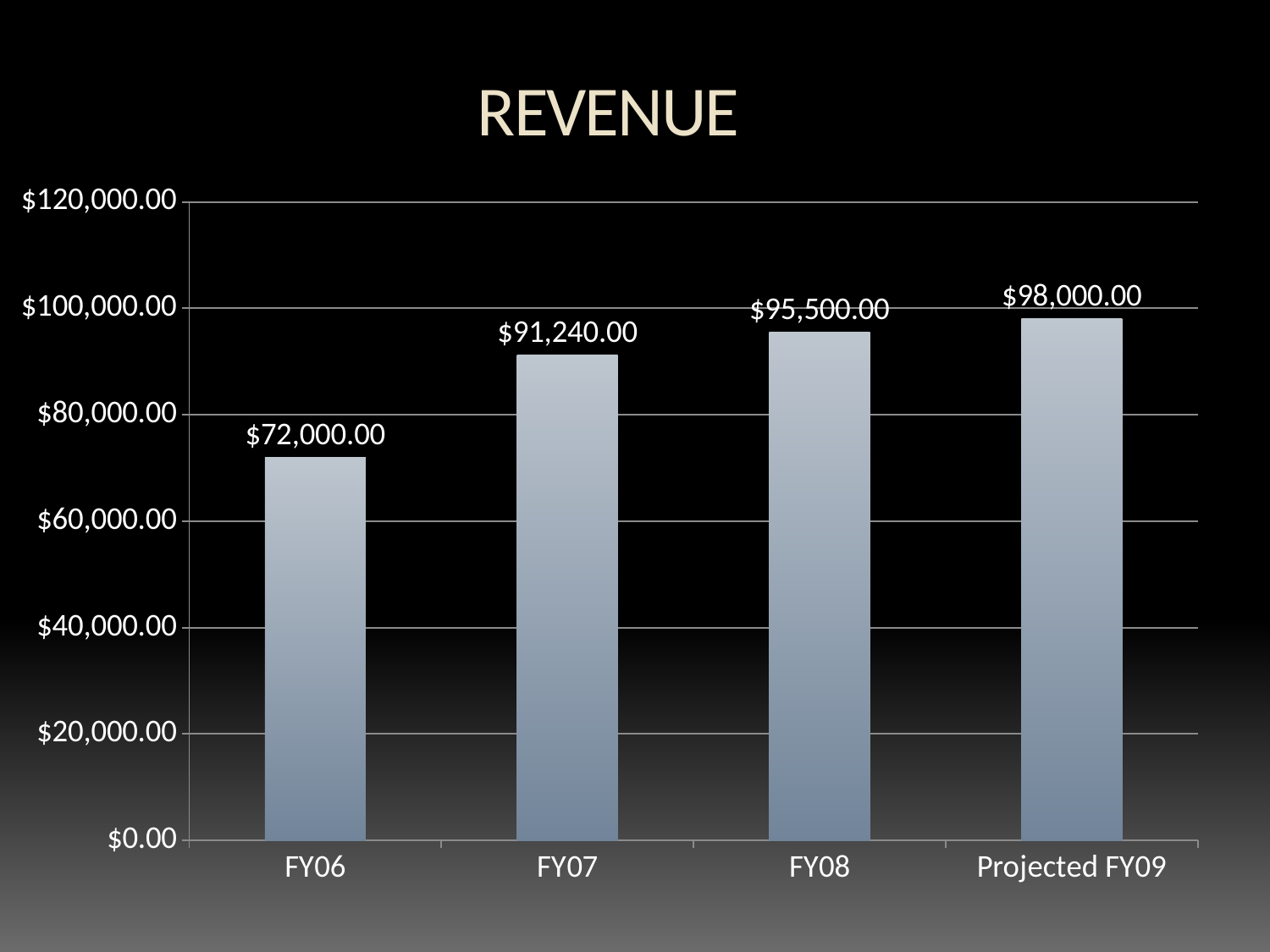
What kind of chart is shown on the slide? bar chart What is the revenue for Projected FY09? $98,000.00 Is the revenue for FY07 greater or less than $100,000.00? less What is the difference in revenue between FY07 and FY06? $19,240.00 What is the revenue for FY07? $91,240.00 Which category has the lowest revenue? FY06 What is the revenue for FY08? $95,500.00 How many categories are shown on the x axis? 4 Which has higher revenue, FY06 or FY08? FY08 What is the revenue for FY06? $72,000.00 What is the difference in revenue between Projected FY09 and FY08? $2,500.00 Which category has the highest revenue? Projected FY09